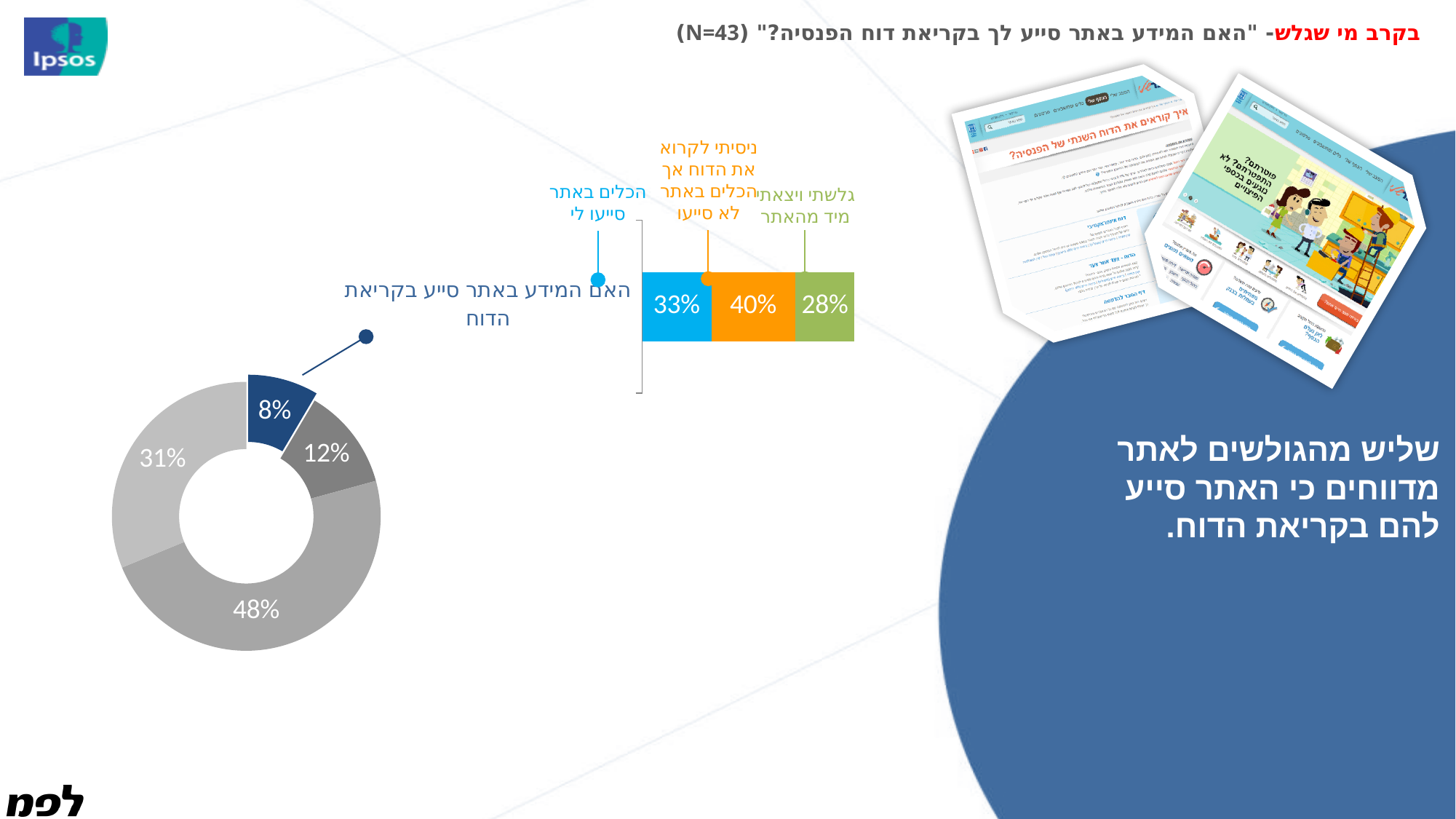
How many slices does the donut chart have? 4 In the stacked bar chart, what percentage is shown for the segment labelled "הכלים באתר סייעו לי"? 33% In the donut chart, what percentage is shown for the slice labelled "האם המידע באתר סייע בקריאת הדוח"? 8% How many segments make up the stacked bar chart? 3 In the stacked bar chart, which segment has the highest value? ניסיתי לקרוא את הדוח אך הכלים באתר לא סייעו In the donut chart, what is the value of the largest slice? 48% In the stacked bar chart, which segment has the lowest value? גלשתי ויצאתי מיד מהאתר In the stacked bar chart, what is the difference between the "ניסיתי לקרוא את הדוח אך הכלים באתר לא סייעו" segment and the "גלשתי ויצאתי מיד מהאתר" segment? 12% In the stacked bar chart, what percentage is shown for the segment labelled "גלשתי ויצאתי מיד מהאתר"? 28% What colour is the "הכלים באתר סייעו לי" segment in the stacked bar chart? Blue In the stacked bar chart, what percentage is shown for the segment labelled "ניסיתי לקרוא את הדוח אך הכלים באתר לא סייעו"? 40% In the stacked bar chart, which is larger: the "הכלים באתר סייעו לי" segment or the "גלשתי ויצאתי מיד מהאתר" segment? הכלים באתר סייעו לי